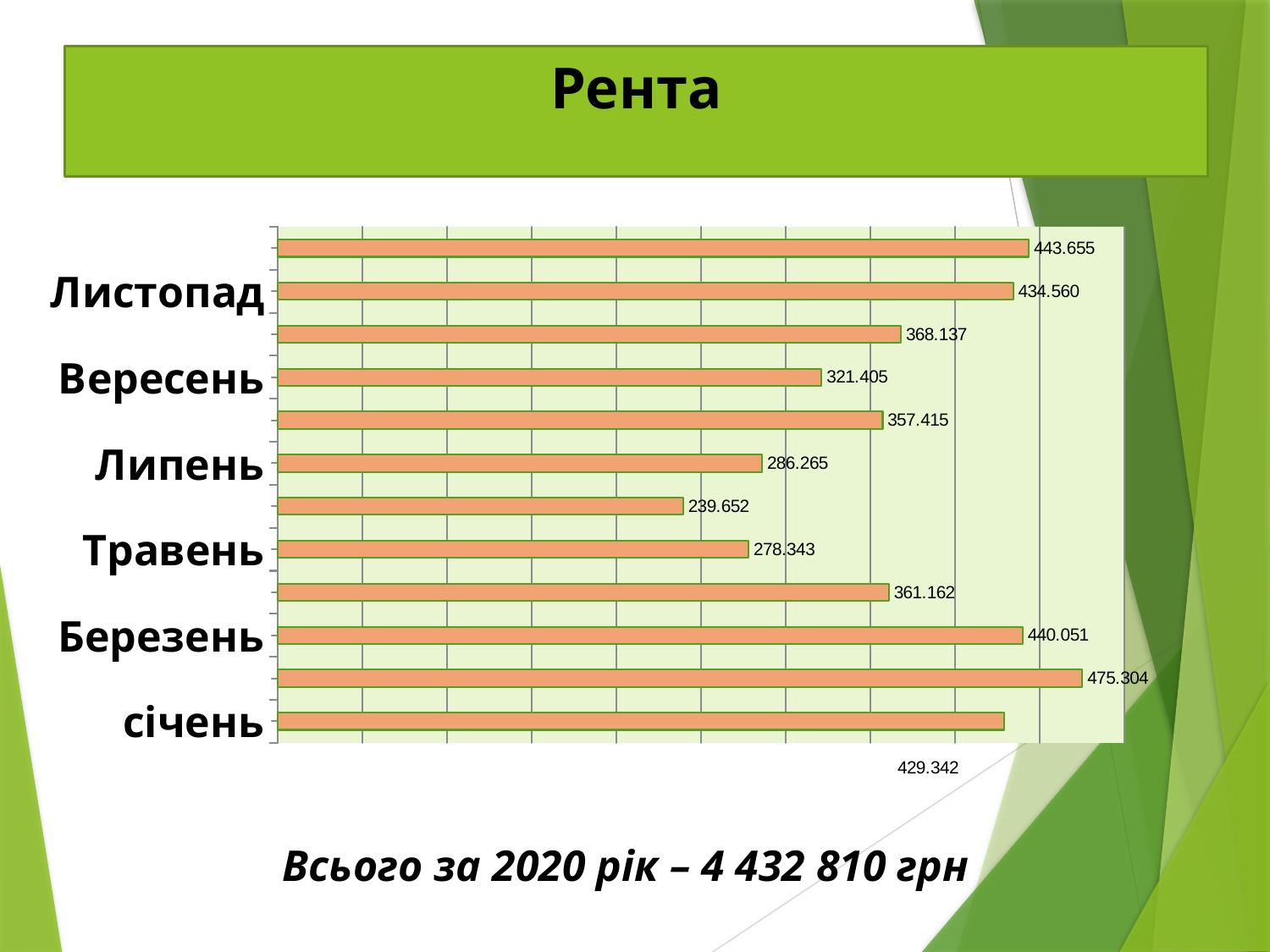
What is the title of the chart? Рента What is the value for Березень? 440.051 What is the value for Липень? 286.265 What is the value for січень? 429.342 How many bars does the chart contain? 12 What is the value for Травень? 278.343 What is the value for Вересень? 321.405 What is the value for Листопад? 434.560 What kind of chart is shown on the slide? bar chart What is the largest value shown on any bar in the chart? 475.304 Which is larger, the value for Березень or the value for Травень? Березень What is the difference between the values for Листопад and Вересень? 113.155